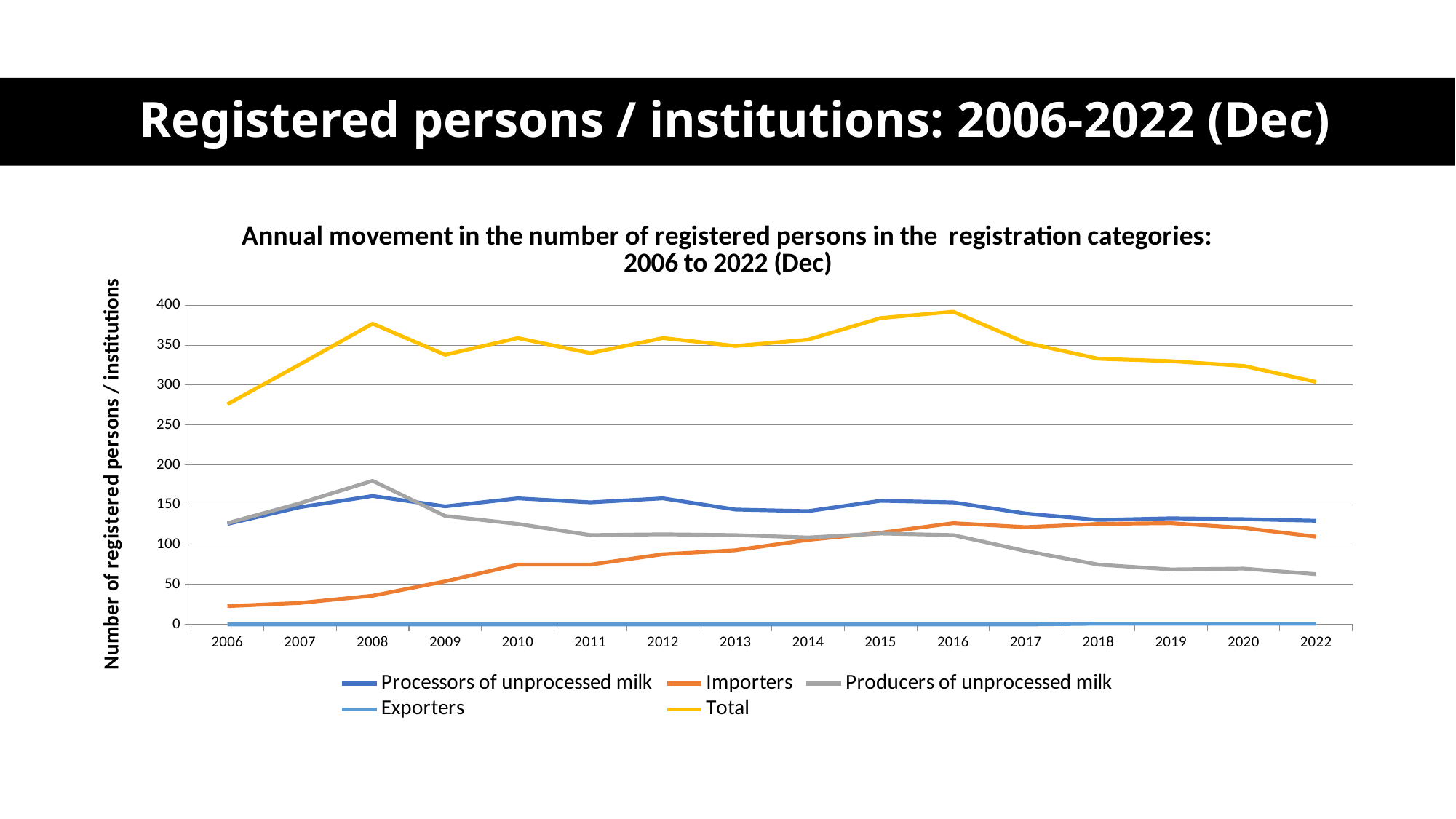
In which year does the Total series reach its highest value? 2016 How many series does the legend list? 5 Does the Importers series rise or fall from 2006 to 2016? rise In which year does the Producers of unprocessed milk series reach its highest value? 2008 Is the value for Total in 2016 greater or less than 350? greater In which year is the Total series at its lowest value? 2006 How many years are plotted along the x axis? 16 Is the value for Importers in 2006 greater or less than 50? less In 2022, which is larger: Processors of unprocessed milk or Importers? Processors of unprocessed milk Is the value for Producers of unprocessed milk in 2022 greater or less than 100? less What kind of chart is shown on the slide? line chart